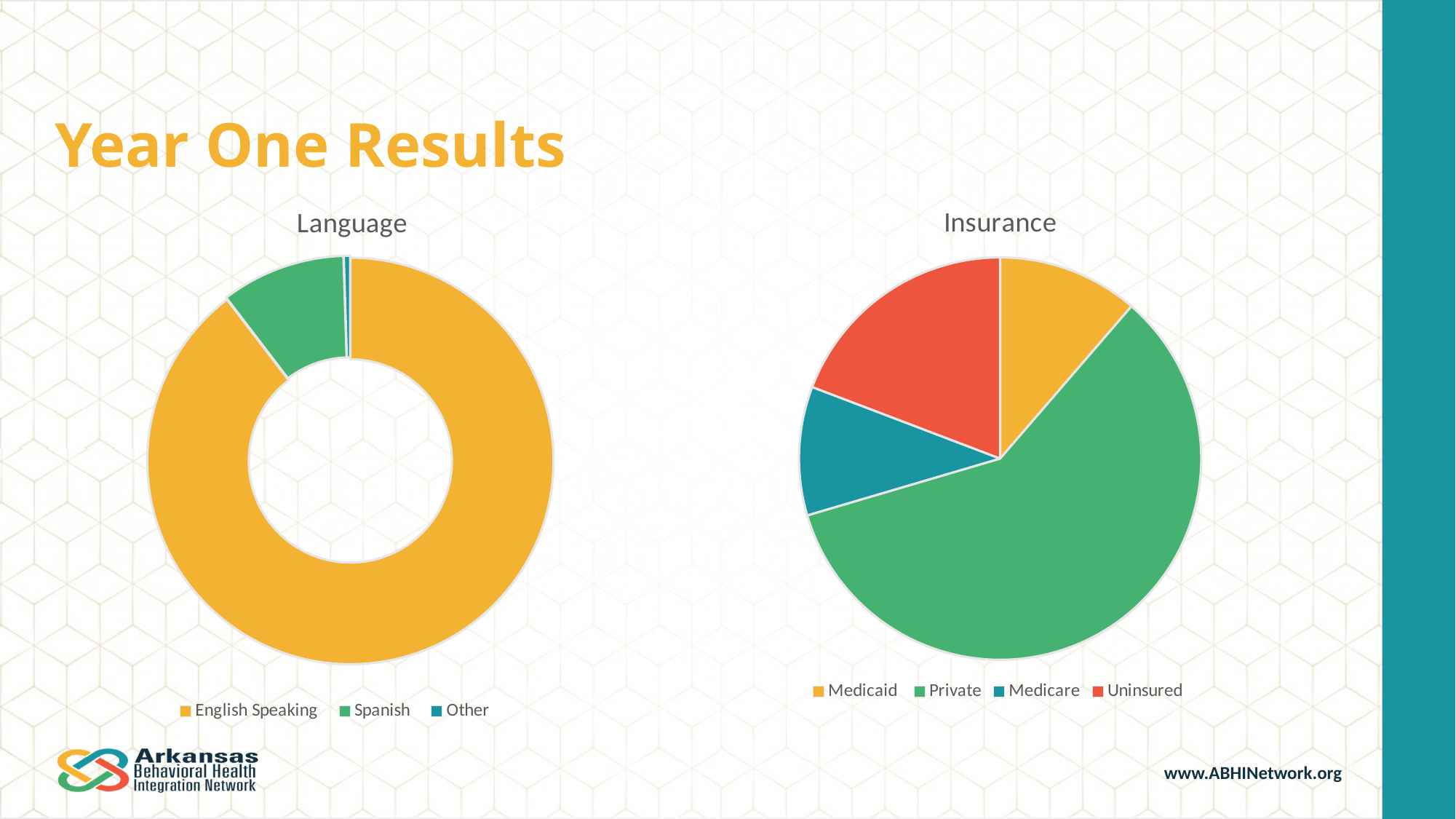
In the Insurance chart, what colour represents Uninsured? red In the Language chart, which is larger, Spanish or Other? Spanish In the Language chart, which category has the smallest share? Other What kind of chart is the Insurance chart? pie chart In the Language chart, which category has the largest share? English Speaking How many categories does the Language chart's legend list? 3 How many categories does the Insurance chart's legend list? 4 In the Insurance chart, which is larger, Uninsured or Medicaid? Uninsured In the Insurance chart, which category has the largest share? Private What kind of chart is the Language chart? doughnut chart In the Insurance chart, which is larger, Private or Uninsured? Private What is the title of the chart on the right side of the slide? Insurance